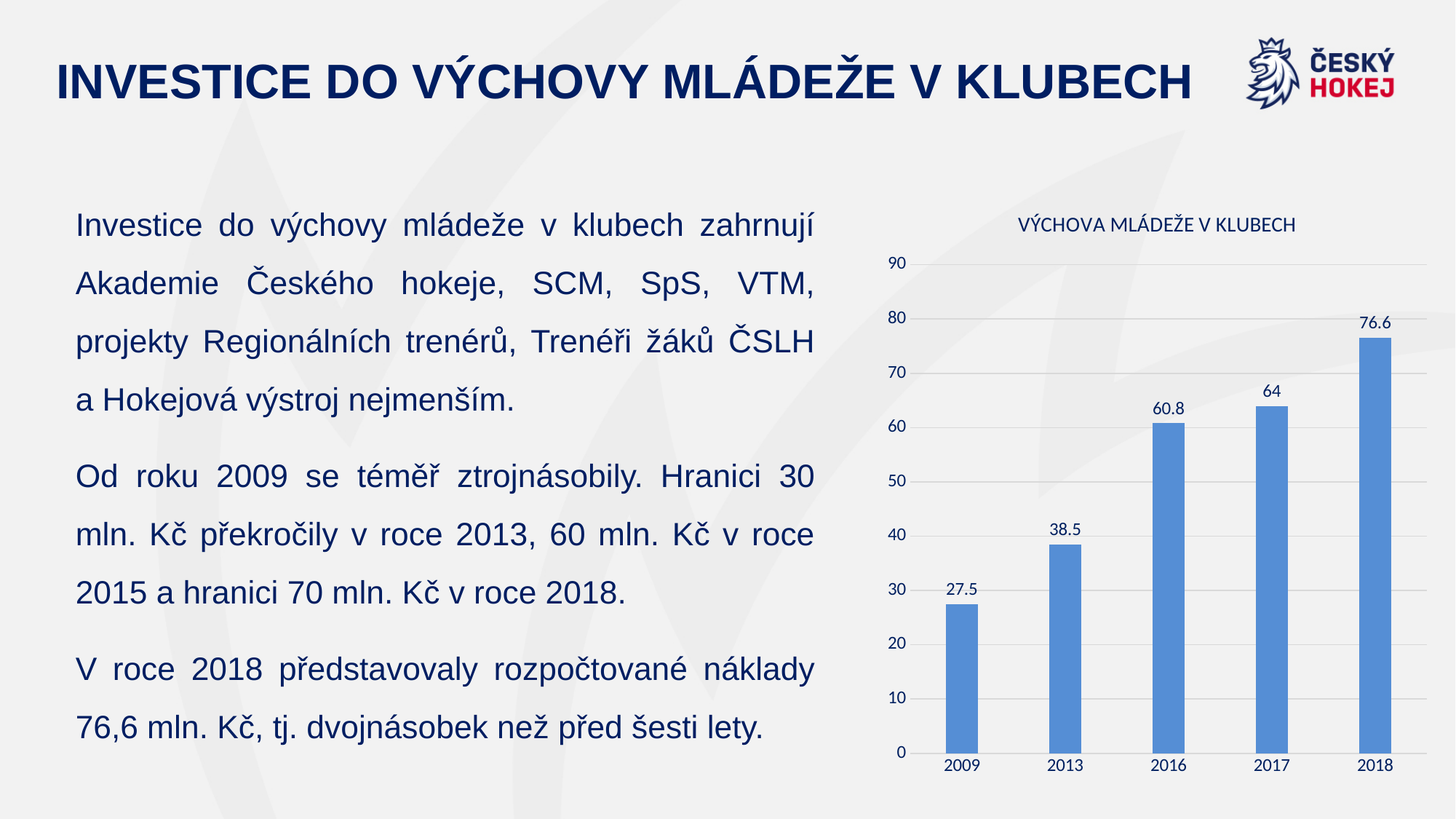
Which year has the highest value? 2018 What is the value for 2018? 76.6 What is the value for 2009? 27.5 Which is larger, the value for 2016 or the value for 2013? 2016 What is the title of the chart? VÝCHOVA MLÁDEŽE V KLUBECH What is the value for 2016? 60.8 Which year has the lowest value? 2009 How many years are shown on the x axis? 5 What is the difference between the values for 2013 and 2009? 11 What is the difference between the values for 2018 and 2017? 12.6 What kind of chart is shown on the slide? bar chart Is the value for 2017 greater or less than 50? greater